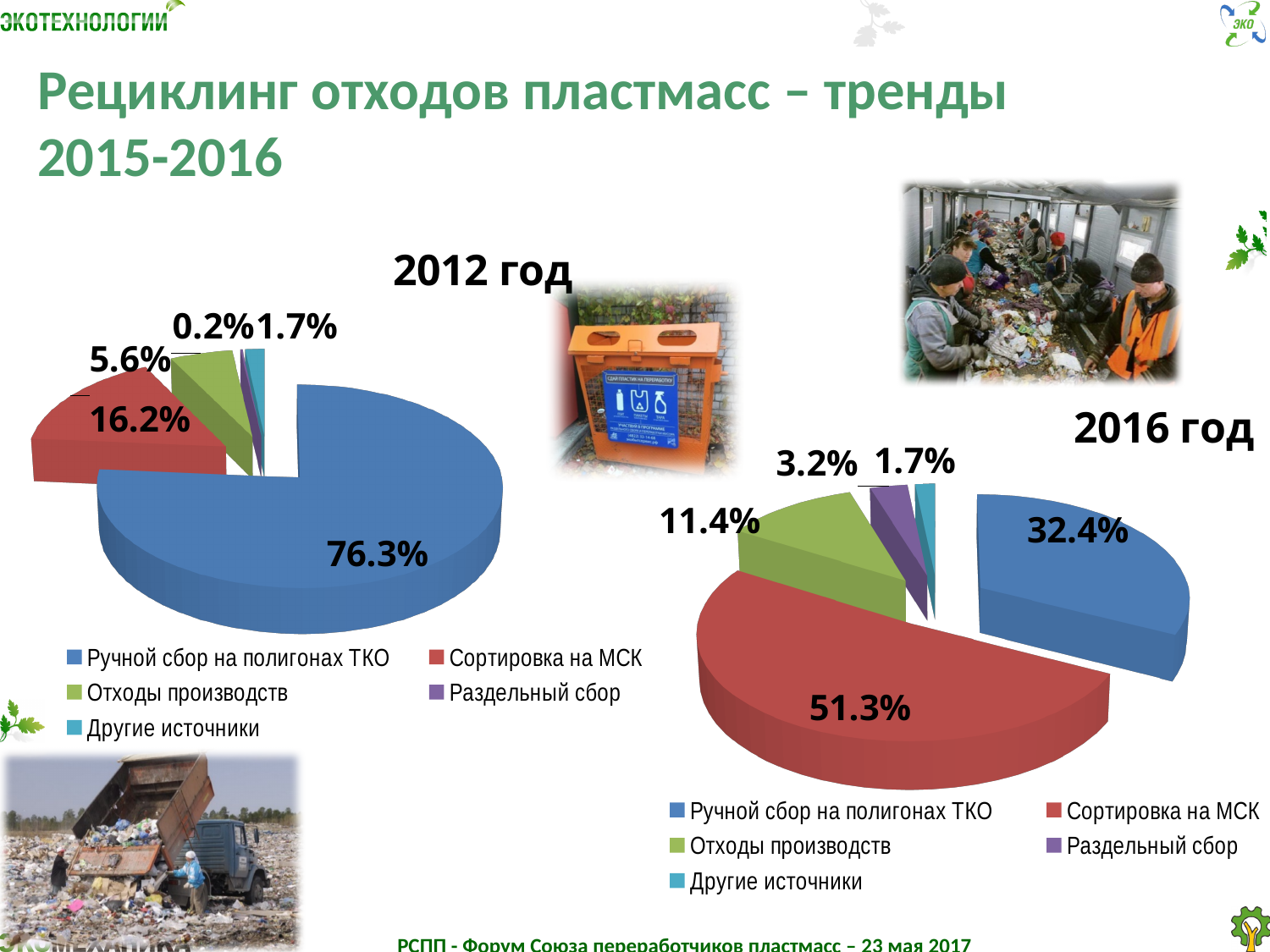
In the 2016 год chart, which category has the largest share? Сортировка на МСК In the 2012 год chart, what share does Ручной сбор на полигонах ТКО have? 76.3% In the 2016 год chart, what share does Отходы производств have? 11.4% How many categories does the legend of the 2016 год chart list? 5 What is the difference between the share of Ручной сбор на полигонах ТКО in the 2012 год chart and in the 2016 год chart? 43.9% In the 2012 год chart, which category has the smallest share? Раздельный сбор What type of chart is the 2012 год chart? Pie chart In the 2012 год chart, what share does Раздельный сбор have? 0.2% In the 2016 год chart, which category has the smallest share? Другие источники In the 2016 год chart, which is larger: Ручной сбор на полигонах ТКО or Сортировка на МСК? Сортировка на МСК In the 2016 год chart, what share does Сортировка на МСК have? 51.3% In the 2012 год chart, which category has the largest share? Ручной сбор на полигонах ТКО